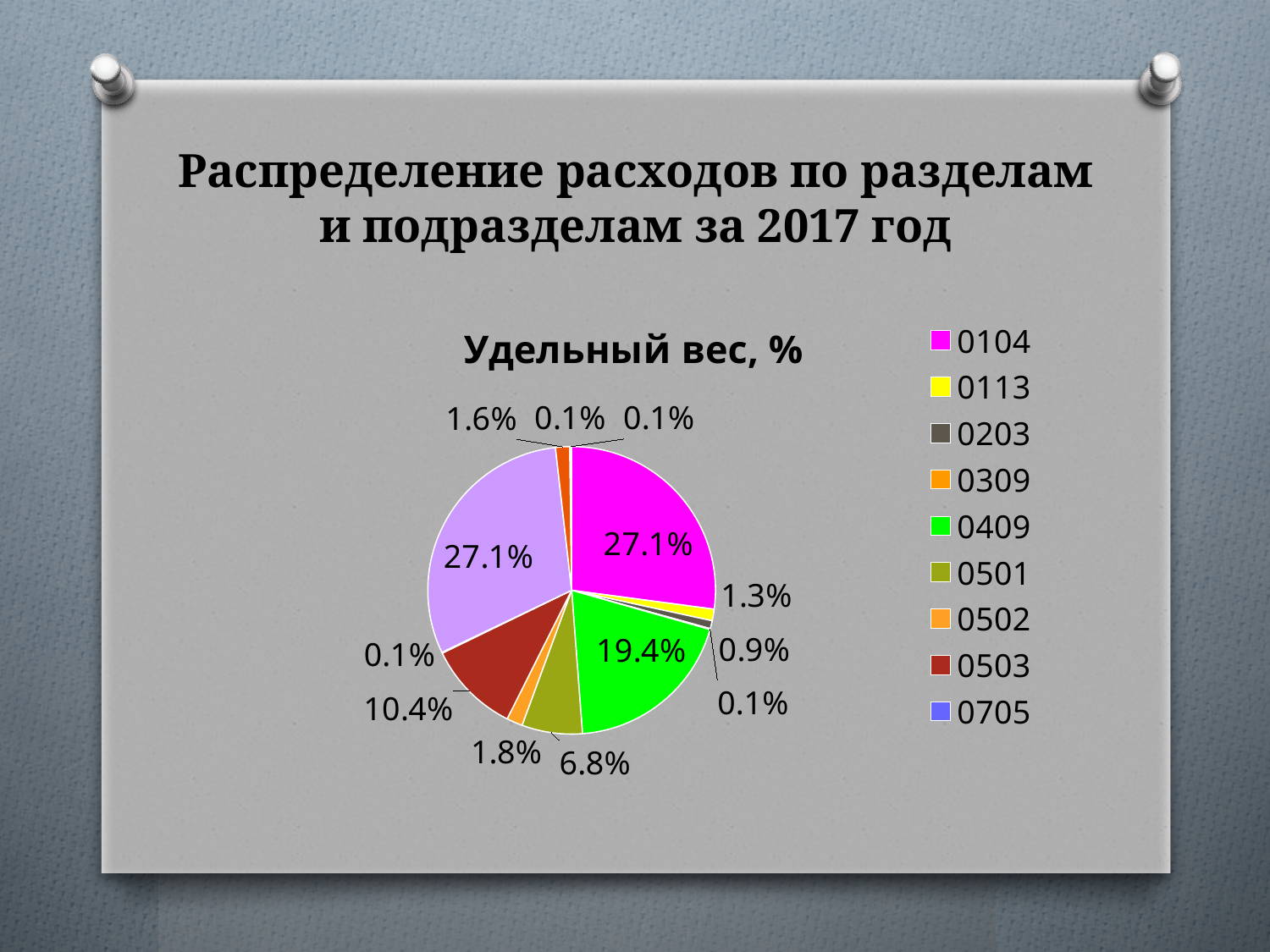
What is the value shown for category 0501? 6.8% What is the difference in percentage points between the shares for 0104 and 0409? 7.7 Which is larger, the share for 0409 or the share for 0503? 0409 What is the value shown for category 0503? 10.4% What share of the pie does category 0104 have? 27.1% How many entries does the legend list? 9 What is the chart title? Удельный вес, % What kind of chart is shown on the slide? pie chart What is the value shown for category 0203? 0.9% What is the value shown for category 0113? 1.3% What is the value shown for category 0409? 19.4% Which is larger, the share for 0501 or the share for 0502? 0501